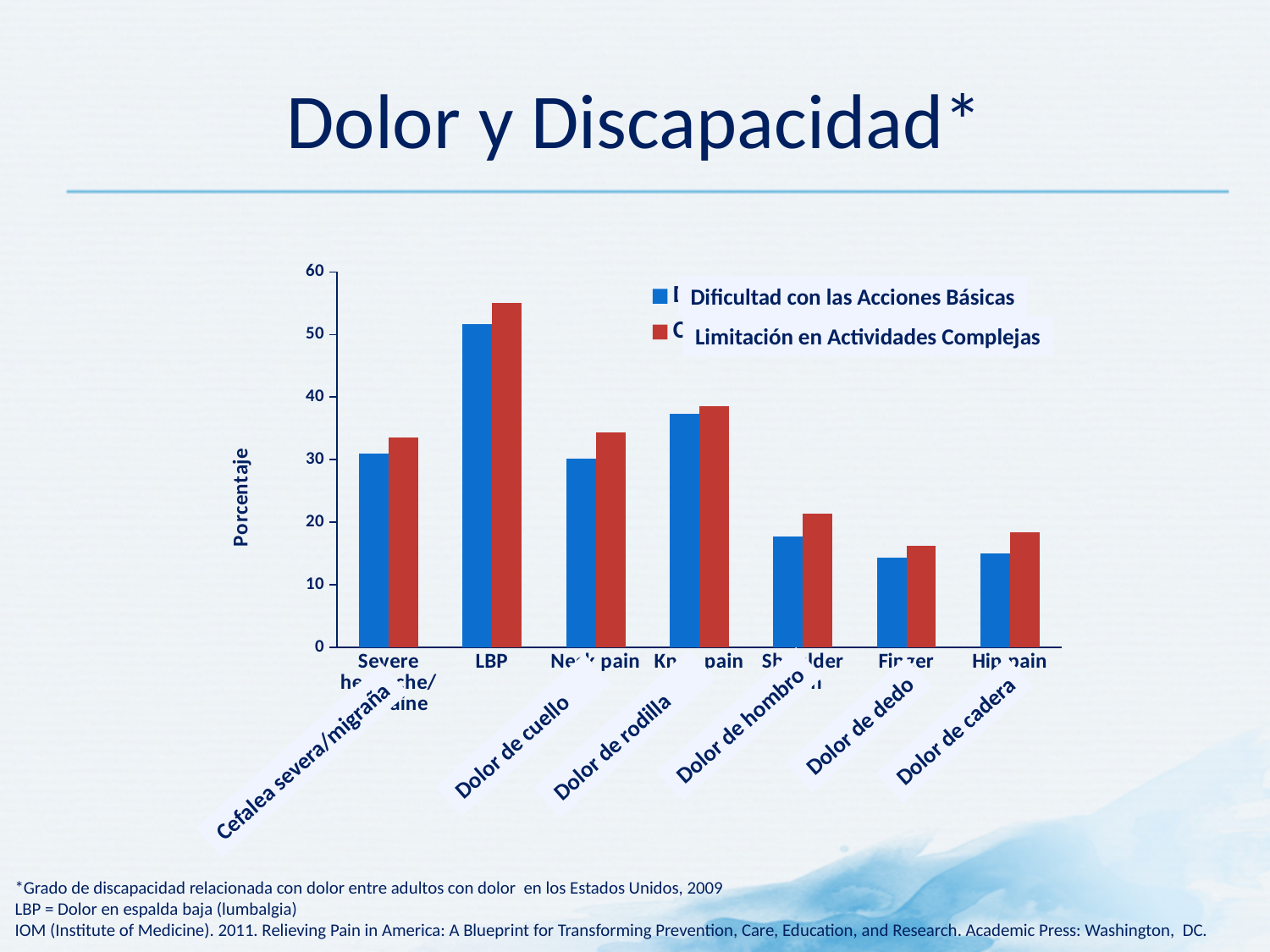
Is the value for Dolor de rodilla (Knee pain) in the Dificultad con las Acciones Básicas series greater or less than 30? greater Is the value for Dolor de cadera (Hip pain) in the Limitación en Actividades Complejas series greater or less than 20? less What is the label on the y axis of the chart? Porcentaje In the Dificultad con las Acciones Básicas series, which is larger: LBP or Dolor de rodilla (Knee pain)? LBP What kind of chart is shown on the slide? bar chart Is the value for Dolor de hombro (Shoulder pain) in the Dificultad con las Acciones Básicas series greater or less than 20? less Which category has the highest value for Limitación en Actividades Complejas? LBP How many pain categories are plotted along the x axis? 7 How many series does the legend list? 2 For Dolor de hombro (Shoulder pain), which series has the larger value: Dificultad con las Acciones Básicas or Limitación en Actividades Complejas? Limitación en Actividades Complejas Which category has the highest value for Dificultad con las Acciones Básicas? LBP